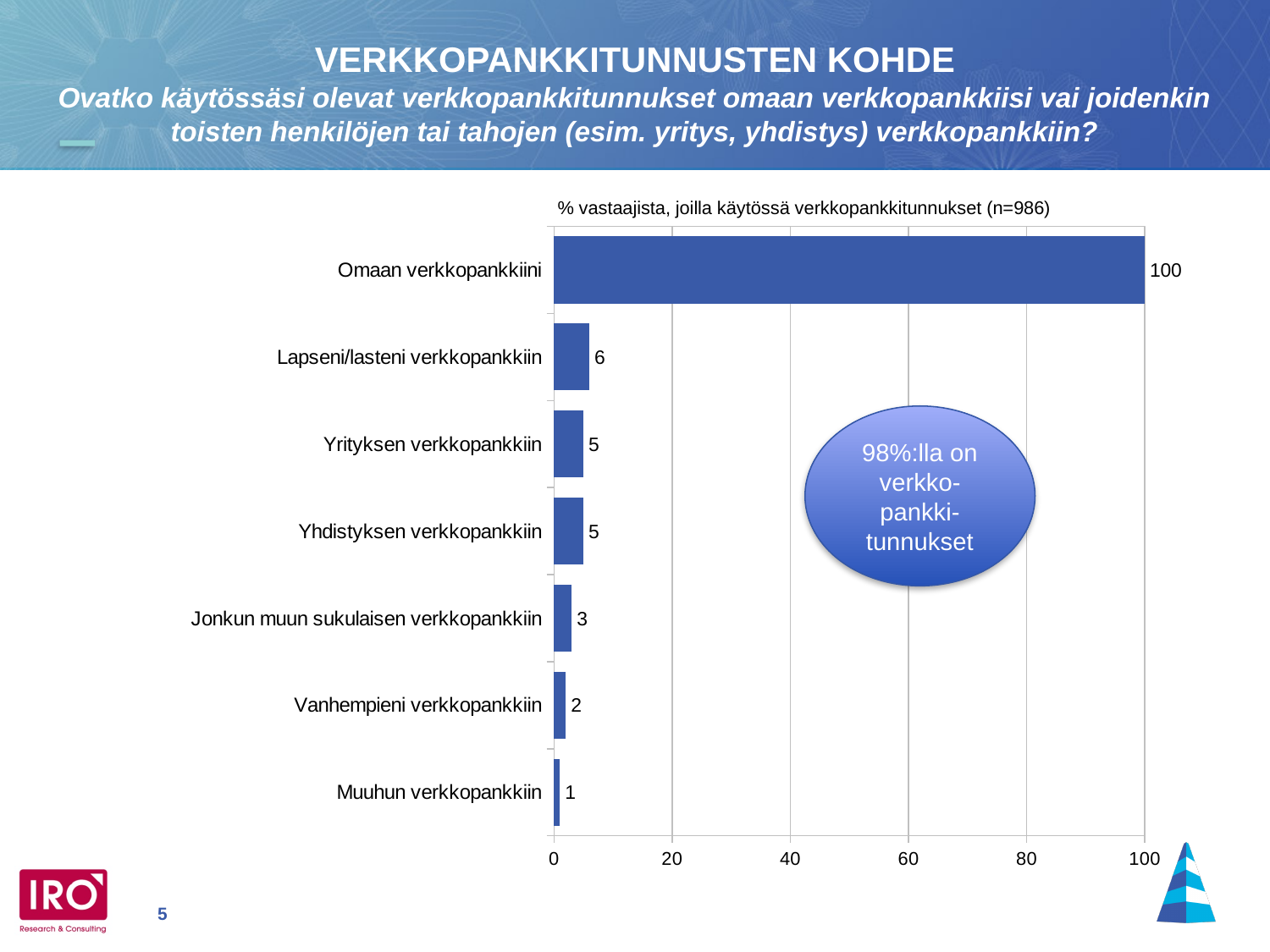
Which category has the highest value? Omaan verkkopankkiini What is the value for "Jonkun muun sukulaisen verkkopankkiin"? 3 What is the value for "Omaan verkkopankkiini"? 100 What does the oval callout on the chart say? 98%:lla on verkkopankkitunnukset What is the chart's title? % vastaajista, joilla käytössä verkkopankkitunnukset (n=986) What is the difference between the values for "Omaan verkkopankkiini" and "Lapseni/lasteni verkkopankkiin"? 94 What kind of chart is shown on the slide? Bar chart Which category has the lowest value? Muuhun verkkopankkiin What is the value for "Vanhempieni verkkopankkiin"? 2 How many categories are shown in the chart? 7 Which is larger, the value for "Lapseni/lasteni verkkopankkiin" or the value for "Yrityksen verkkopankkiin"? Lapseni/lasteni verkkopankkiin What is the value for "Lapseni/lasteni verkkopankkiin"? 6